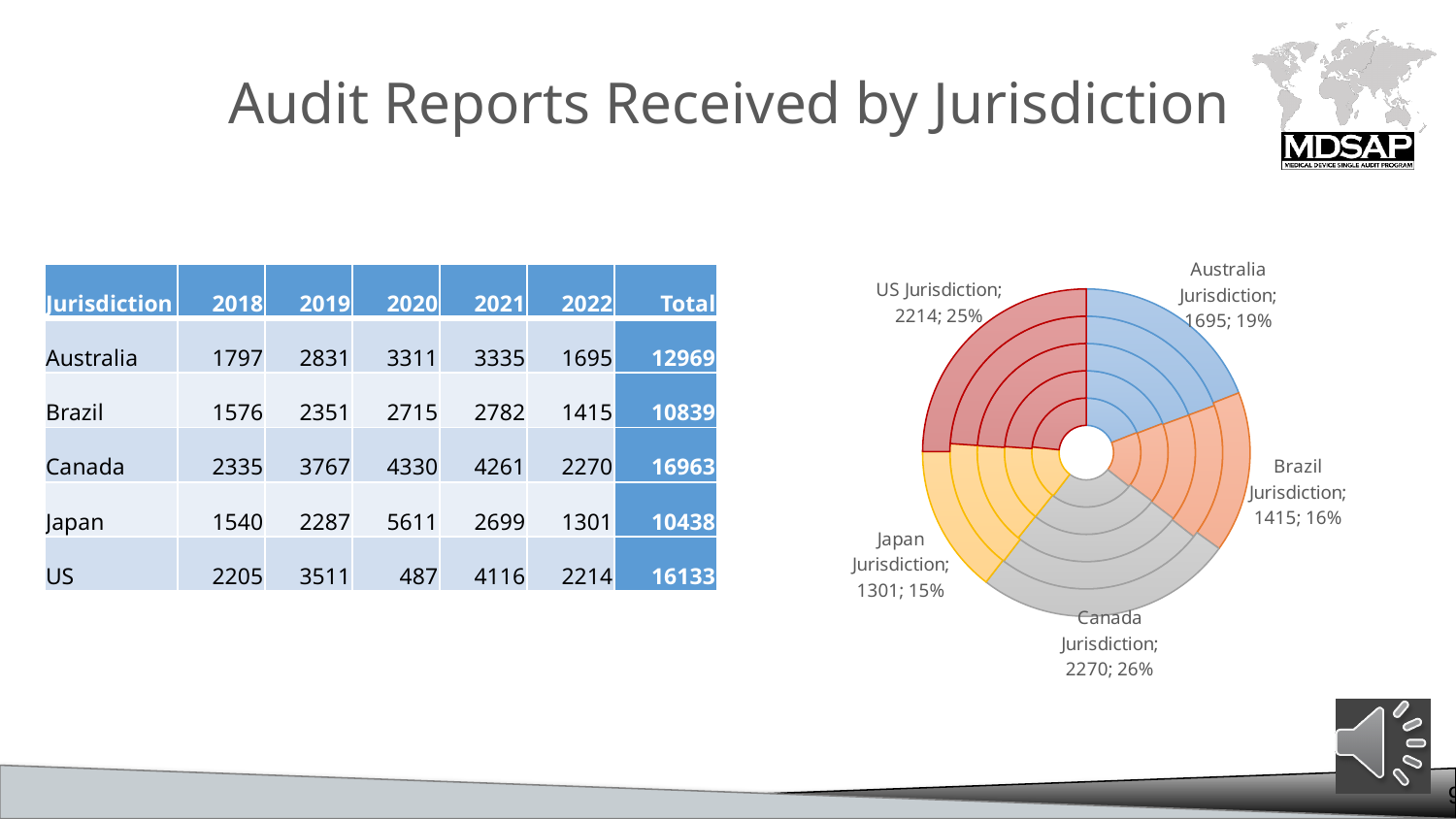
What value is shown for the Japan Jurisdiction slice in the pie chart? 1301 What share of the pie does the Brazil Jurisdiction slice represent? 16% How many slices does the pie chart have? 5 What value is shown for the US Jurisdiction slice in the pie chart? 2214 In the pie chart, which is larger: the Australia Jurisdiction value or the Brazil Jurisdiction value? Australia Jurisdiction What kind of chart is shown on the right of the slide? Doughnut chart What colour is the US Jurisdiction slice in the pie chart? Red What value is shown for the Canada Jurisdiction slice in the pie chart? 2270 Which jurisdiction has the largest slice in the pie chart? Canada Jurisdiction Which jurisdiction has the smallest slice in the pie chart? Japan Jurisdiction In the pie chart, what is the difference between the Canada Jurisdiction value and the Japan Jurisdiction value? 969 What share of the pie does the Australia Jurisdiction slice represent? 19%